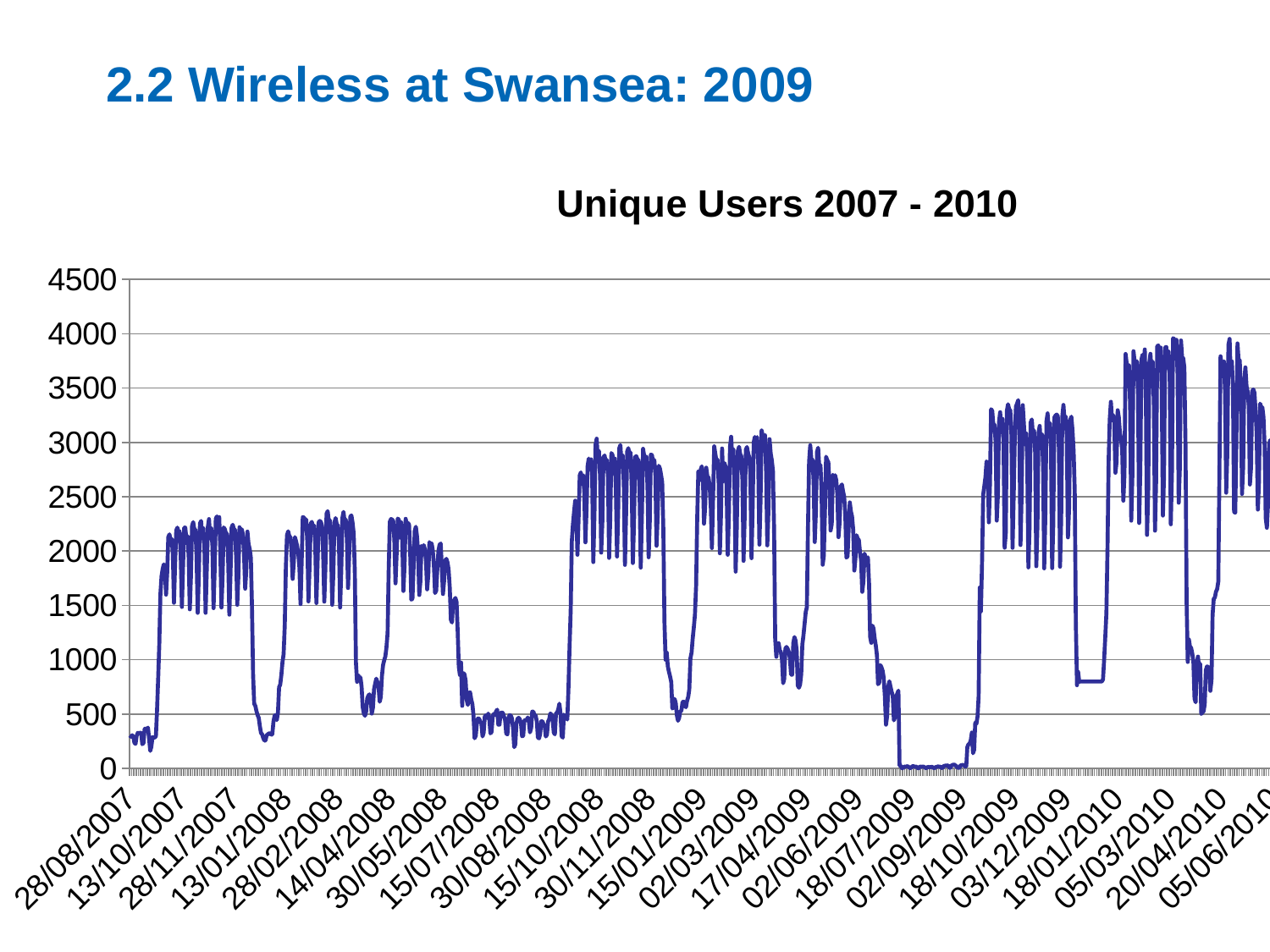
Which period has higher peak values: around 13/10/2007 or around 05/03/2010? around 05/03/2010 What kind of chart is shown on the slide? line chart Do the peak values of unique users generally rise or fall from 2007 to 2010? rise In which period does the chart reach its lowest values: around 02/09/2009 or around 28/02/2008? around 02/09/2009 Is the value around 15/10/2008 greater or less than 1500? greater What is the title of the chart? Unique Users 2007 - 2010 Is the value around 30/07/2008 greater or less than 1000? less What is the highest value shown on the vertical axis? 4500 Is the value at the start of the series, around 28/08/2007, greater or less than 500? less